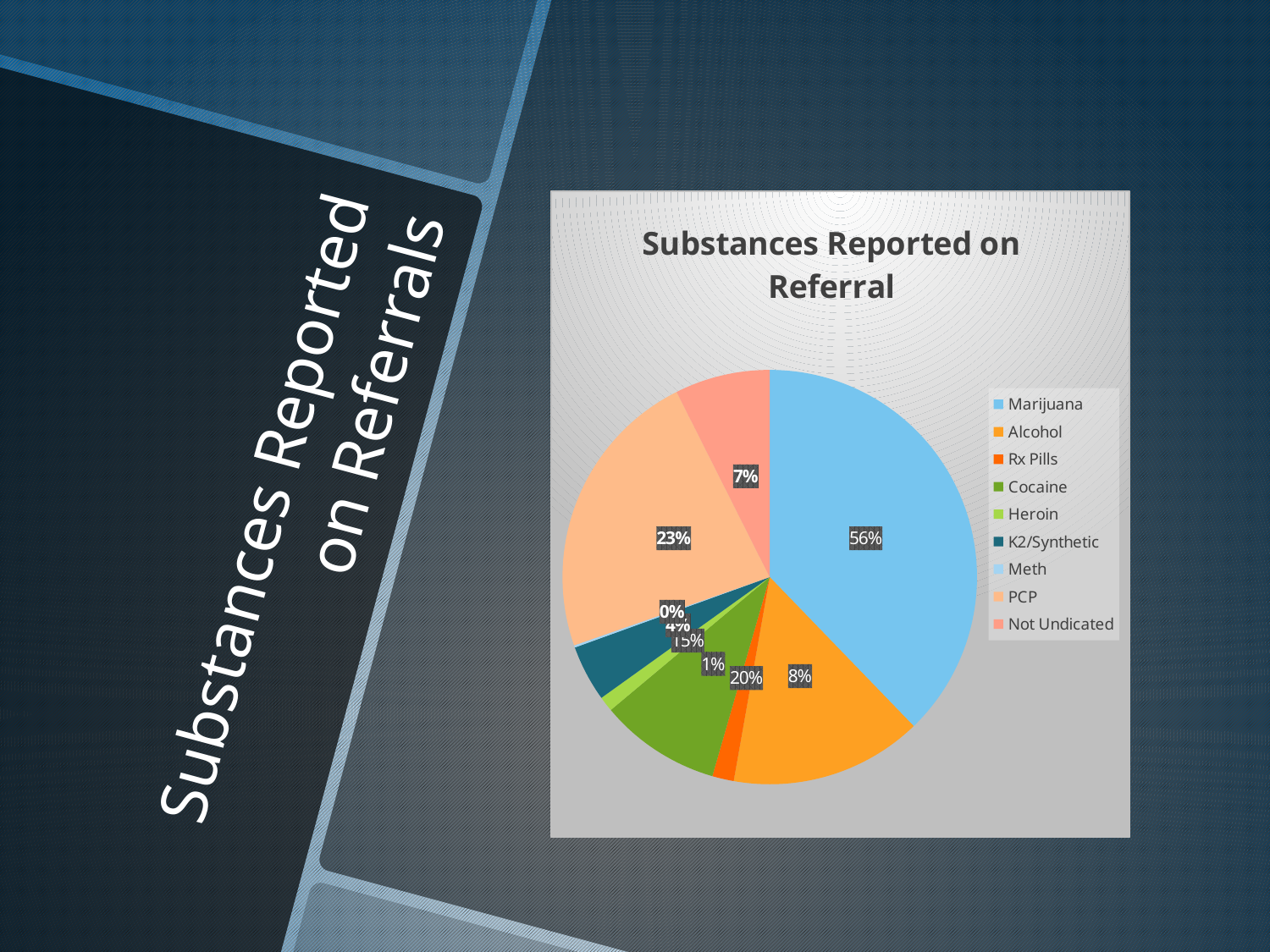
What percentage is shown for PCP? 23% Which substance has the largest slice of the pie? Marijuana Which legend entry is listed last in the chart's legend? Not Undicated What is the difference in percentage points between PCP and Not Undicated? 16 What share of the pie does Marijuana account for? 56% Which is larger, the slice for Marijuana or the slice for PCP? Marijuana What percentage is shown for Not Undicated? 7% Which is larger, the slice for Alcohol or the slice for Cocaine? Alcohol What is the difference in percentage points between Marijuana and PCP? 33 What kind of chart is shown on the slide? pie chart What is the title of the chart? Substances Reported on Referral How many substances are listed in the chart's legend? 9